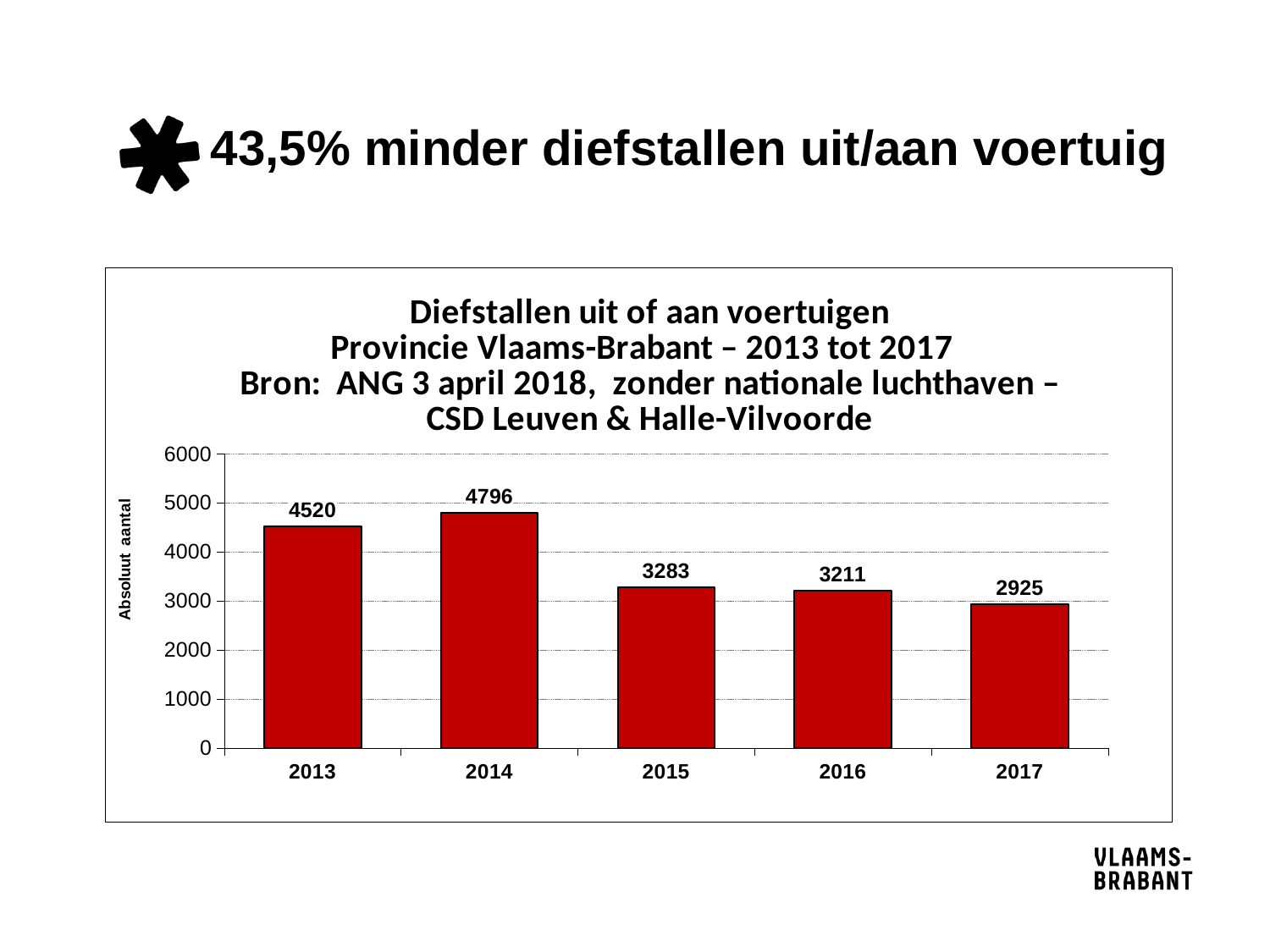
What is the label of the y axis? Absoluut aantal What kind of chart is shown on the slide? bar chart What is the value for 2015? 3283 What is the difference between the values for 2013 and 2014? 276 Which year has the highest value? 2014 What is the value for 2017? 2925 Which is larger, the value for 2013 or the value for 2015? 2013 What is the difference between the values for 2014 and 2017? 1871 Is the value for 2016 greater or less than 4000? less Which year has the lowest value? 2017 How many years are shown on the x axis? 5 What is the value for 2013? 4520